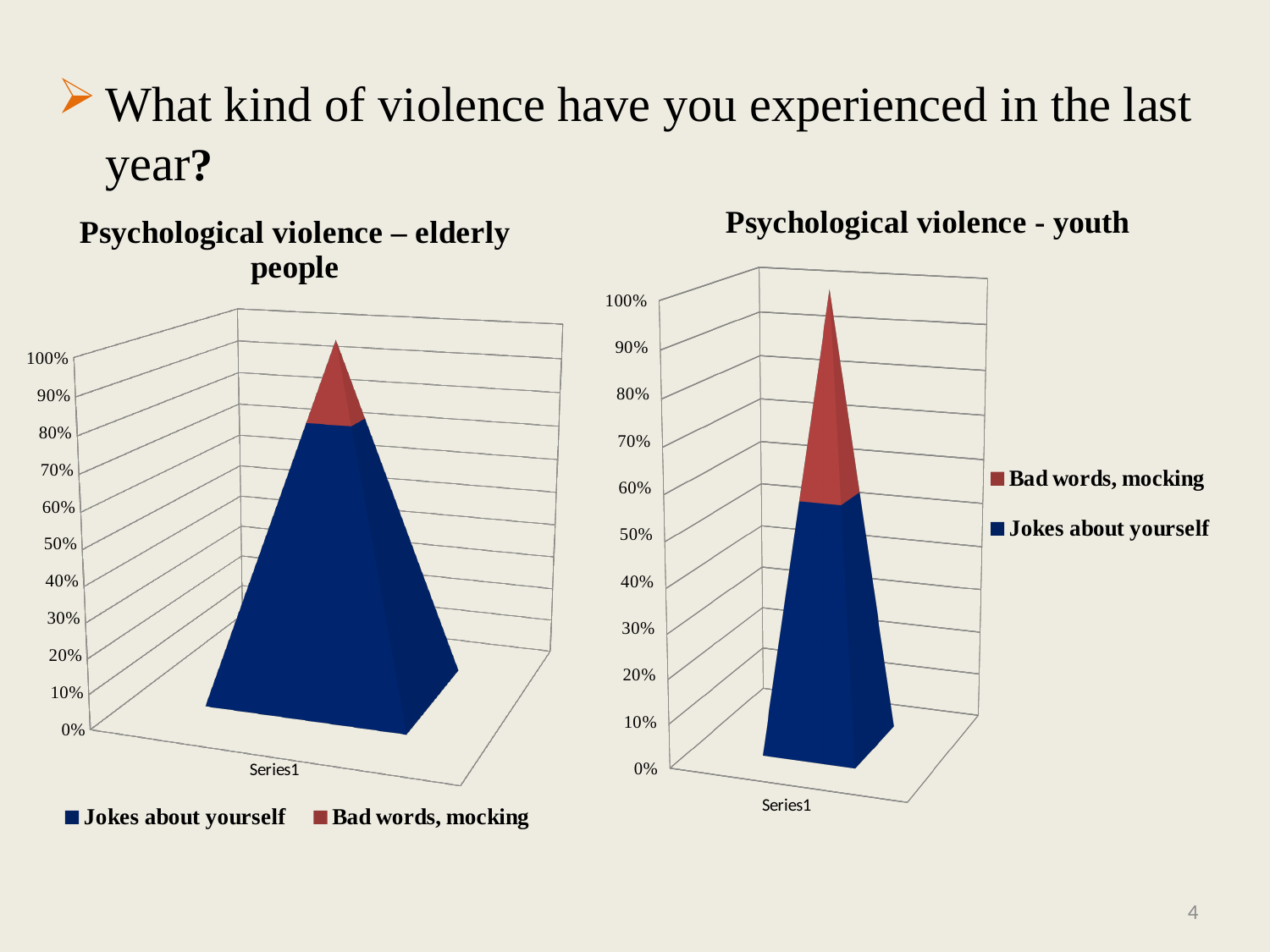
How many series does the legend list in the 'Psychological violence – elderly people' chart? 2 In the 'Psychological violence – elderly people' chart, which is larger: 'Jokes about yourself' or 'Bad words, mocking'? Jokes about yourself What kind of chart is the 'Psychological violence – elderly people' chart? Bar chart How many series does the legend list in the 'Psychological violence - youth' chart? 2 In the 'Psychological violence – elderly people' chart, is the value for 'Bad words, mocking' greater or less than 50%? less In the 'Psychological violence – elderly people' chart, is the value for 'Jokes about yourself' greater or less than 50%? greater How many categories are shown on the x axis of the 'Psychological violence - youth' chart? 1 What is the title of the chart on the left side of the slide? Psychological violence – elderly people In the 'Psychological violence - youth' chart, which is larger: 'Jokes about yourself' or 'Bad words, mocking'? Jokes about yourself In the 'Psychological violence - youth' chart, is the value for 'Jokes about yourself' greater or less than 40%? greater What is the highest value shown on the y axis of the 'Psychological violence – elderly people' chart? 100% In the 'Psychological violence - youth' chart, which colour represents 'Bad words, mocking'? Red